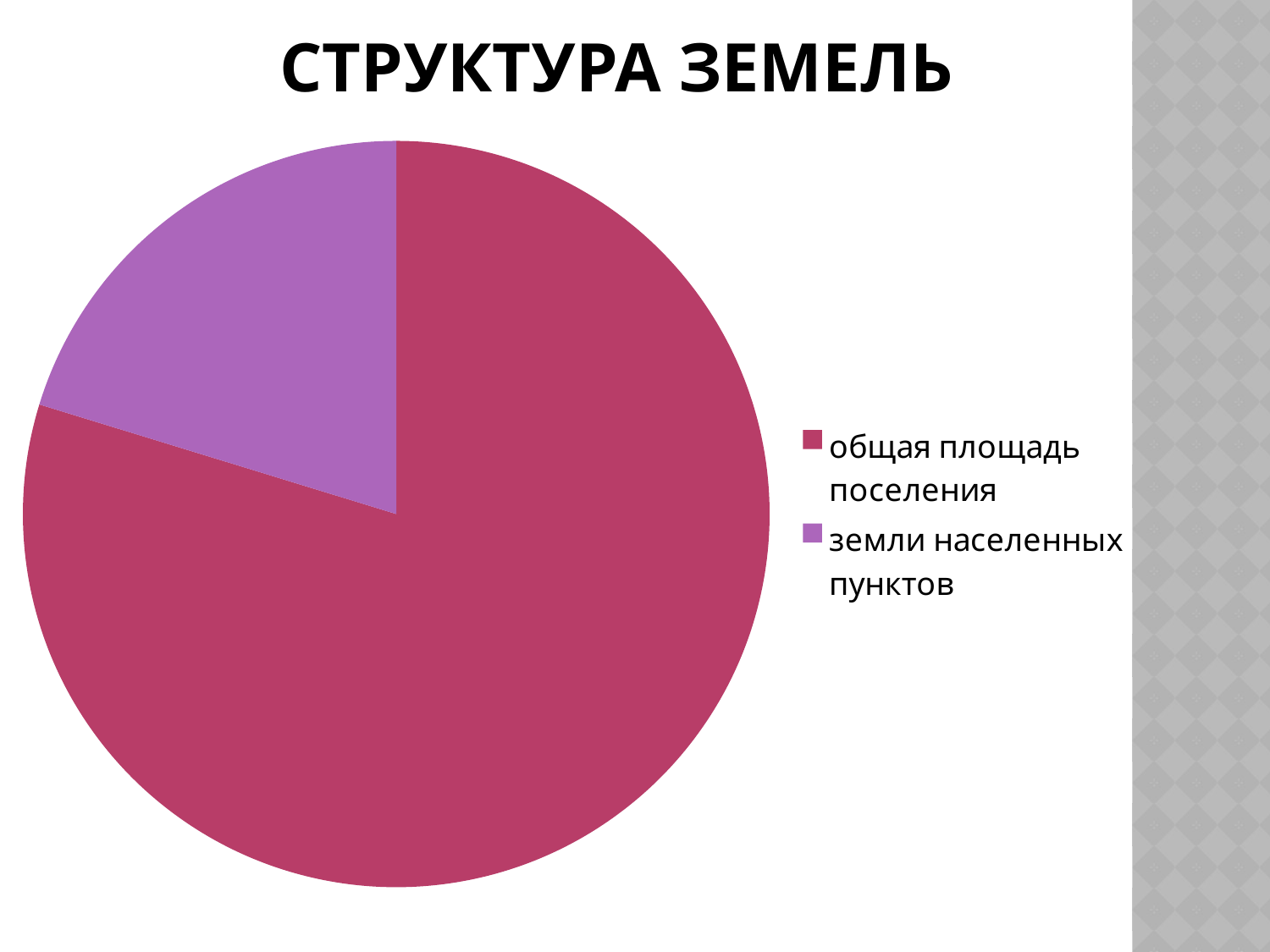
What kind of chart is shown on the slide? pie chart What colour is the slice for земли населенных пунктов? purple Which category has the smallest slice in the pie chart? земли населенных пунктов Which category has the largest slice in the pie chart? общая площадь поселения How many entries does the legend of the pie chart list? 2 What is the title of the slide with the pie chart? СТРУКТУРА ЗЕМЕЛЬ Which slice is larger: общая площадь поселения or земли населенных пунктов? общая площадь поселения How many slices does the pie chart have? 2